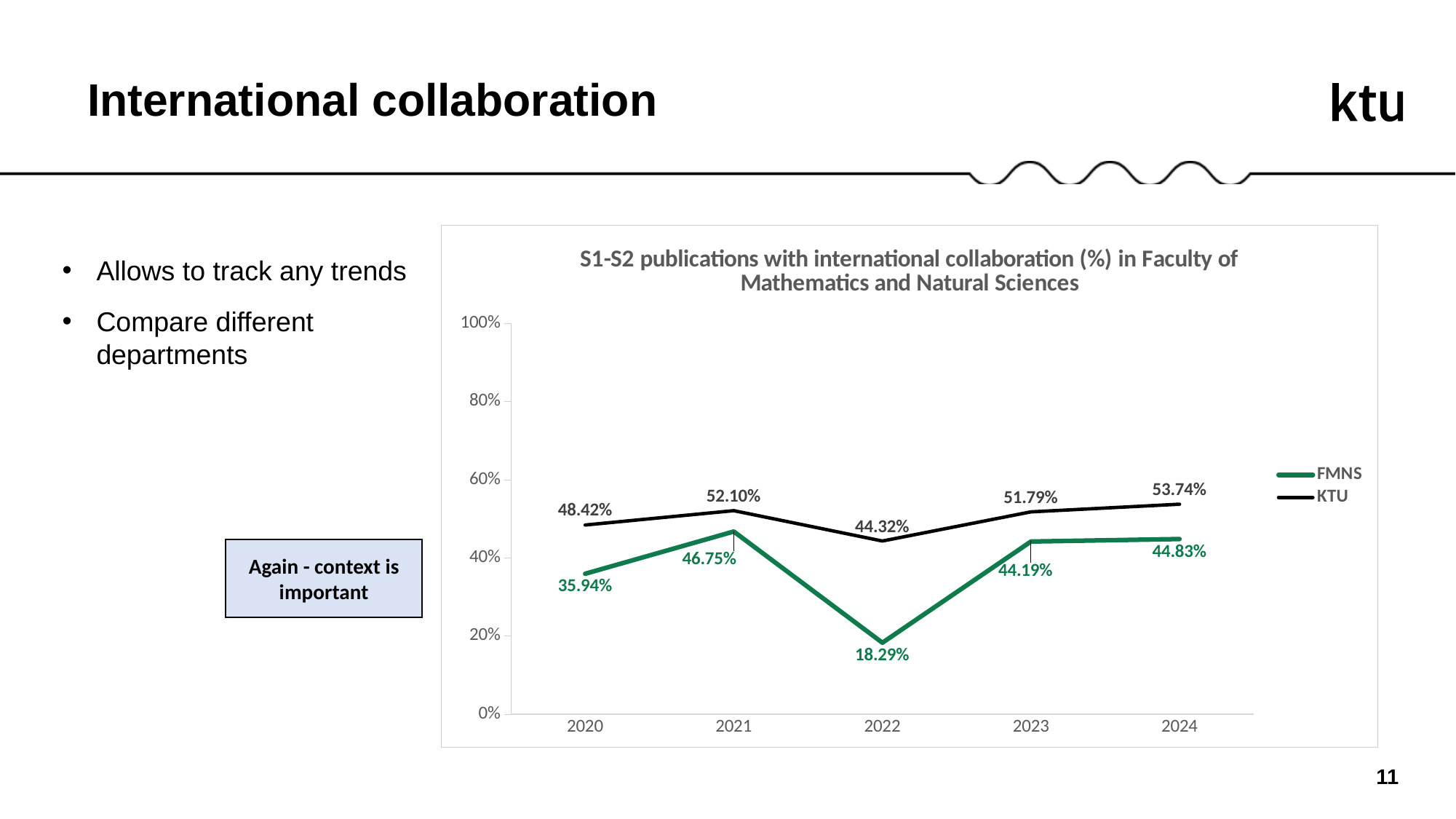
Which series has the larger value in 2023, FMNS or KTU? KTU How many years are shown on the x axis? 5 In which year is the KTU value highest? 2024 What is the FMNS value for 2020? 35.94% How many series does the legend list? 2 Does the FMNS value rise or fall from 2021 to 2022? Fall What is the difference between the KTU and FMNS values in 2022? 26.03% In which year is the FMNS value lowest? 2022 What kind of chart is shown on the slide? Line chart What is the FMNS value for 2022? 18.29% What is the KTU value for 2024? 53.74% What is the KTU value for 2021? 52.10%